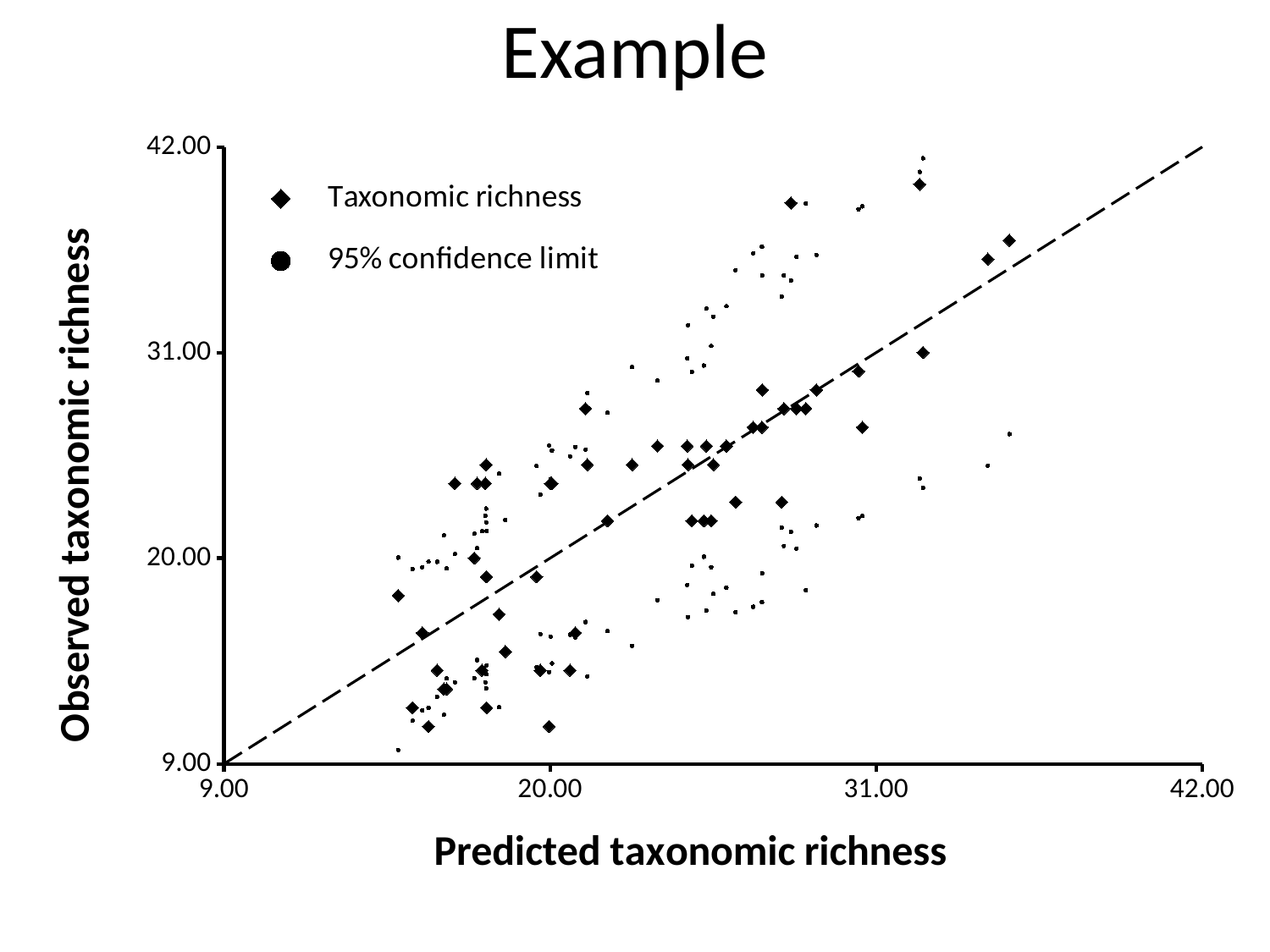
How many series does the legend list? 2 Is the highest observed taxonomic richness among the Taxonomic richness diamond points greater or less than 31.00? greater What kind of chart is shown on the slide? scatter chart What are the two entries in the chart's legend? Taxonomic richness; 95% confidence limit As predicted taxonomic richness increases along the x axis, do the observed taxonomic richness values generally rise or fall? rise Is the observed taxonomic richness of the Taxonomic richness point with the highest predicted taxonomic richness greater or less than 31.00? greater What is the title of the chart? Example Is the observed taxonomic richness of the Taxonomic richness point with the lowest predicted taxonomic richness greater or less than 20.00? less